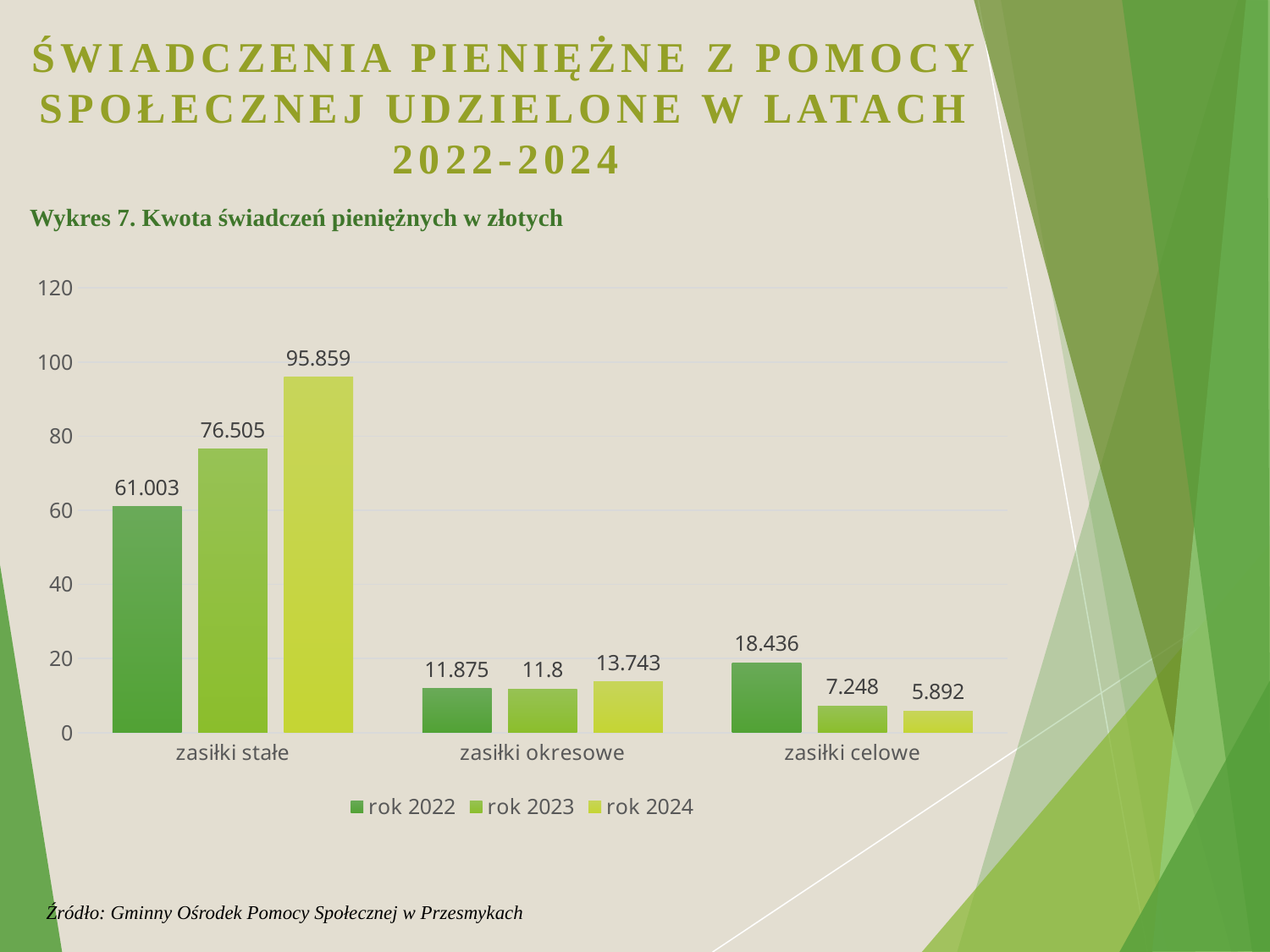
What is the value for rok 2024 in the zasiłki stałe category? 95.859 Which category has the highest value for rok 2022? zasiłki stałe What kind of chart is shown on the slide? bar chart Is the value for rok 2023 in zasiłki stałe greater or less than 80? less How many series does the legend list? 3 Which category has the lowest value for rok 2024? zasiłki celowe What is the value for rok 2023 in the zasiłki okresowe category? 11.8 Do the values for zasiłki stałe rise or fall from rok 2022 to rok 2024? rise What is the value for rok 2022 in the zasiłki celowe category? 18.436 How many categories are shown on the x axis? 3 What is the difference between the rok 2024 and rok 2022 values for zasiłki stałe? 34.856 Which is larger for zasiłki celowe: the rok 2022 value or the rok 2023 value? rok 2022